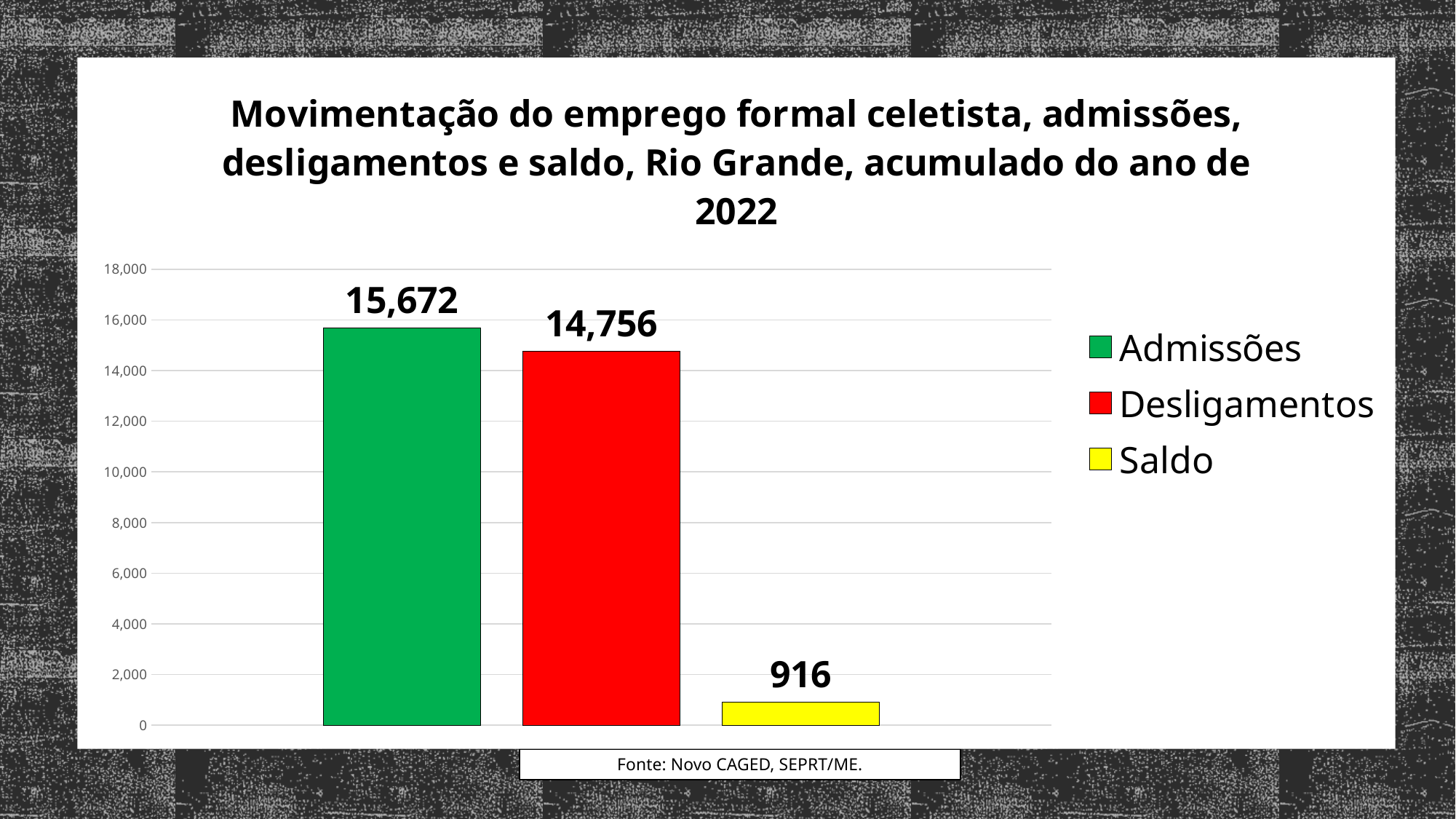
Which is larger, Admissões or Desligamentos? Admissões What colour is the bar for Saldo? yellow What is the value for Saldo? 916 Which series has the lowest value? Saldo What is the difference between Admissões and Desligamentos? 916 Is the value for Desligamentos greater or less than 16,000? less What is the value for Desligamentos? 14,756 Which series has the highest value? Admissões What kind of chart is shown on the slide? bar chart What is the value for Admissões? 15,672 How many bars are plotted in the chart? 3 How many series does the legend list? 3